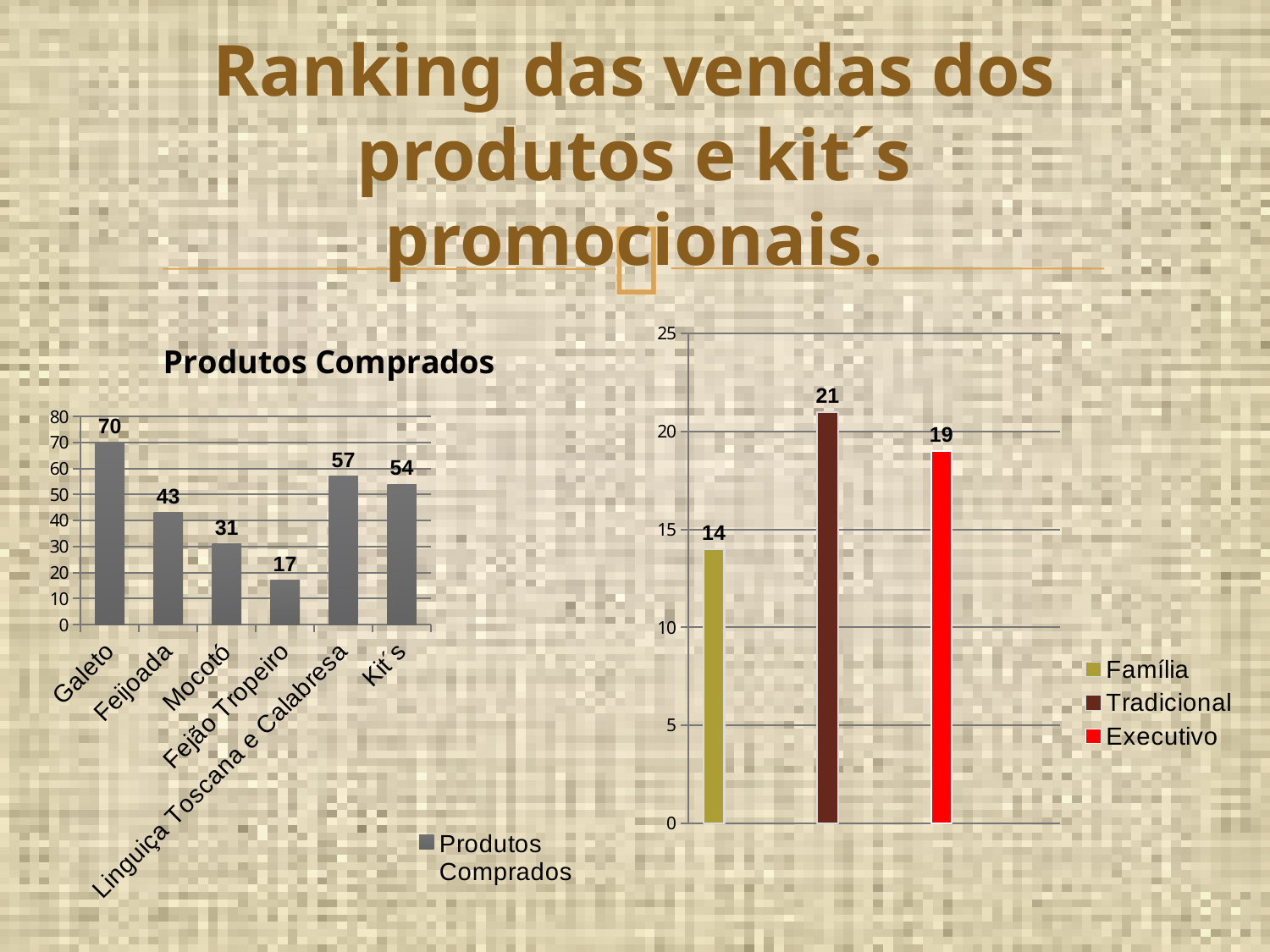
In the 'Produtos Comprados' chart, which category has the highest value? Galeto In the 'Produtos Comprados' chart, what is the value for Galeto? 70 How many series does the legend of the chart on the right list? 3 In the 'Produtos Comprados' chart, what is the value for Feijão Tropeiro? 17 In the 'Produtos Comprados' chart, what is the difference between Linguiça Toscana e Calabresa and Kit´s? 3 In the 'Produtos Comprados' chart, which category has the lowest value? Feijão Tropeiro In the chart on the right, what is the difference between Tradicional and Executivo? 2 In the 'Produtos Comprados' chart, how many categories are shown on the x axis? 6 In the 'Produtos Comprados' chart, which is larger, Feijoada or Mocotó? Feijoada What kind of chart is the 'Produtos Comprados' chart? Bar chart In the chart on the right, what is the value for Tradicional? 21 In the chart on the right, which series has the lowest value? Família